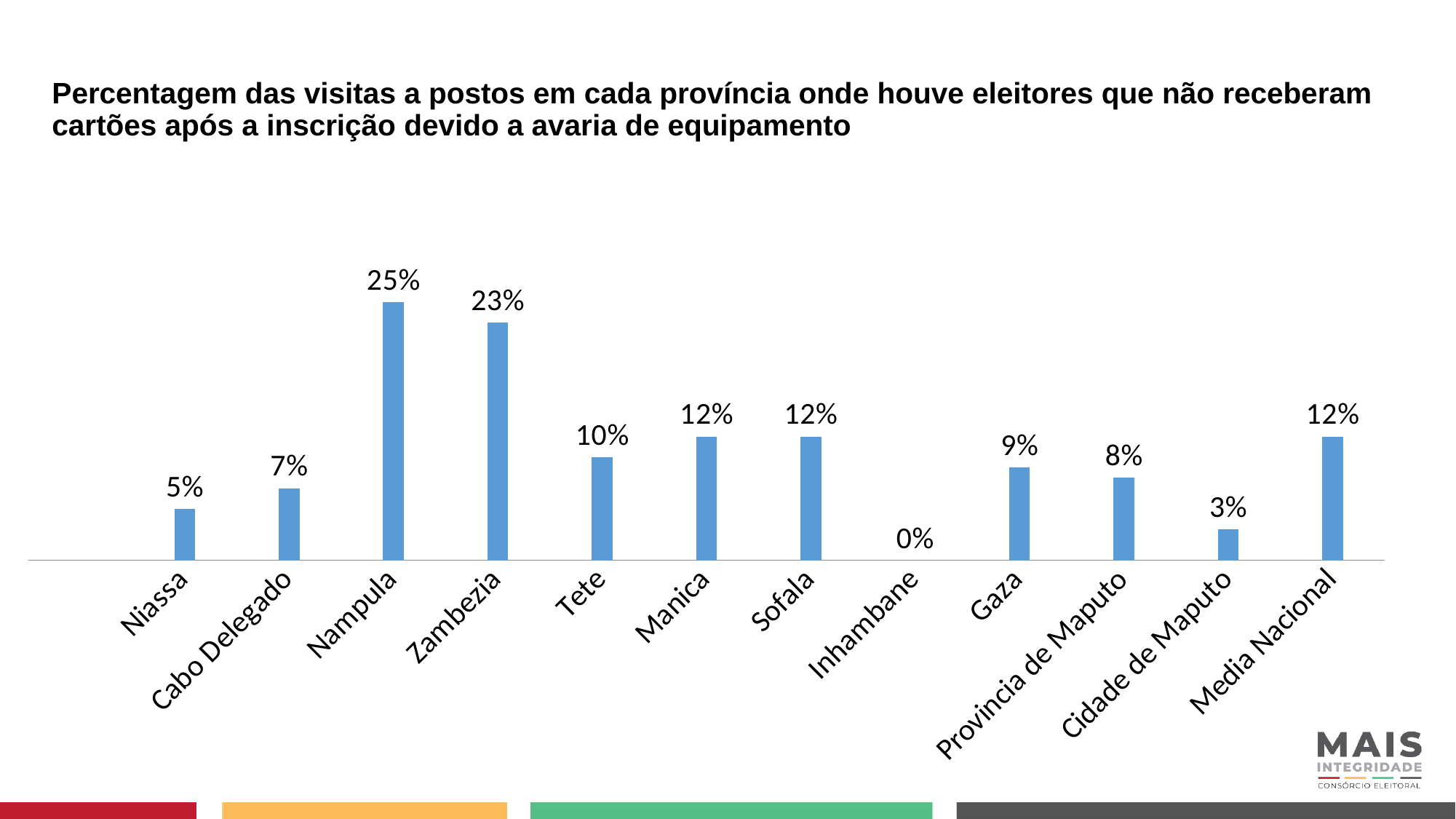
What colour are the bars in the chart? Blue Which province has the highest value? Nampula What is the value for Media Nacional? 12% Which is larger, the value for Cabo Delegado or the value for Tete? Tete What kind of chart is shown on the slide? Bar chart Which is larger, the value for Gaza or the value for Provincia de Maputo? Gaza What is the value for Cidade de Maputo? 3% What is the difference between the values for Nampula and Zambezia? 2% Which category has the lowest value? Inhambane How many categories are shown on the x axis? 12 What is the difference between the values for Tete and Niassa? 5% What is the value for Nampula? 25%